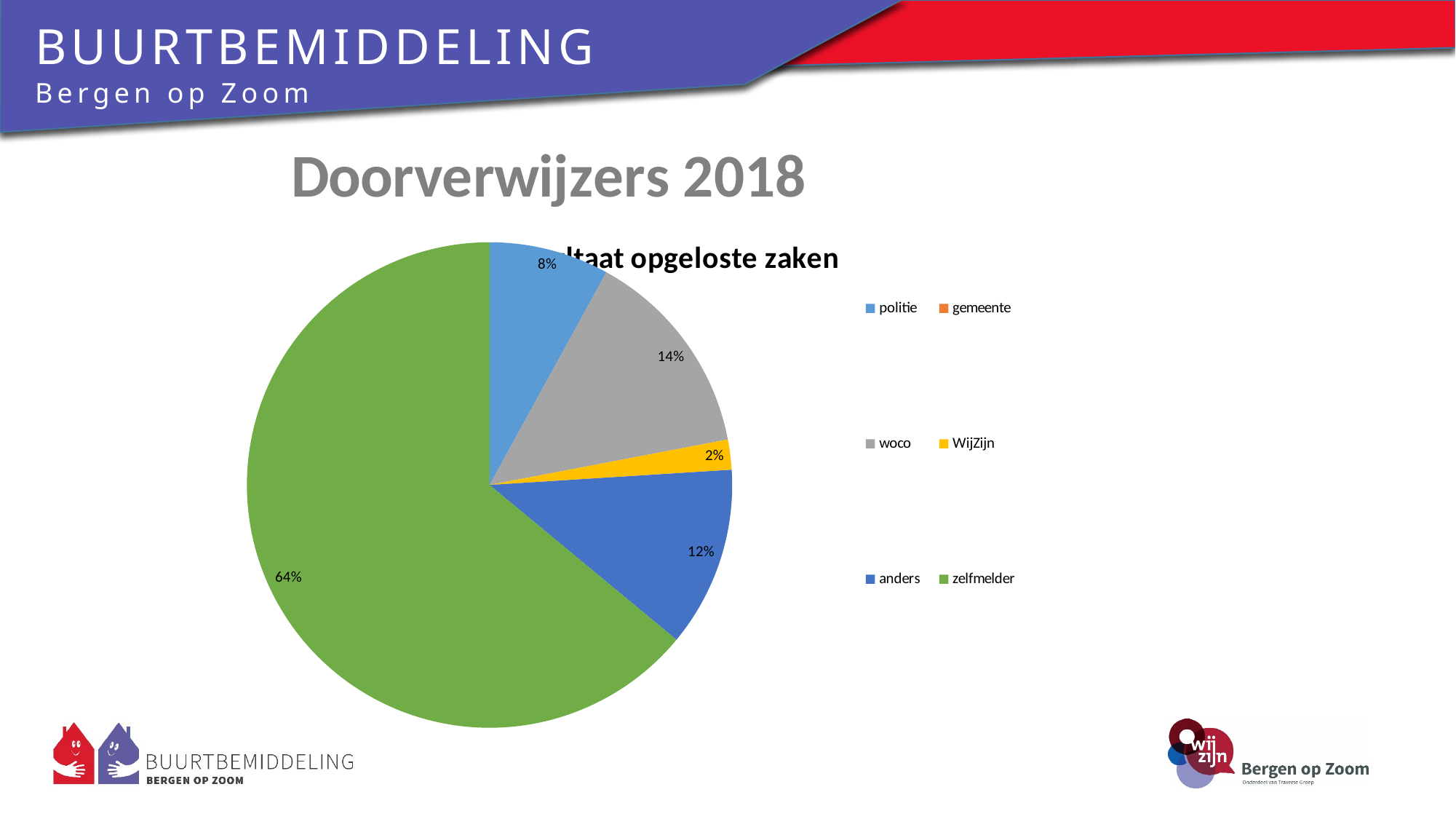
What is the difference between the zelfmelder share and the woco share? 50% What kind of chart is shown on the slide? pie chart What is the value shown for politie? 8% What percentage of the pie is the zelfmelder slice? 64% Which category has the largest slice of the pie? zelfmelder Which is larger, the woco slice or the anders slice? woco Which labelled slice of the pie is the smallest? WijZijn What is the value shown for WijZijn? 2% How many entries does the legend list? 6 What is the value shown for anders? 12% What colour is the zelfmelder slice? green What is the value shown for woco? 14%